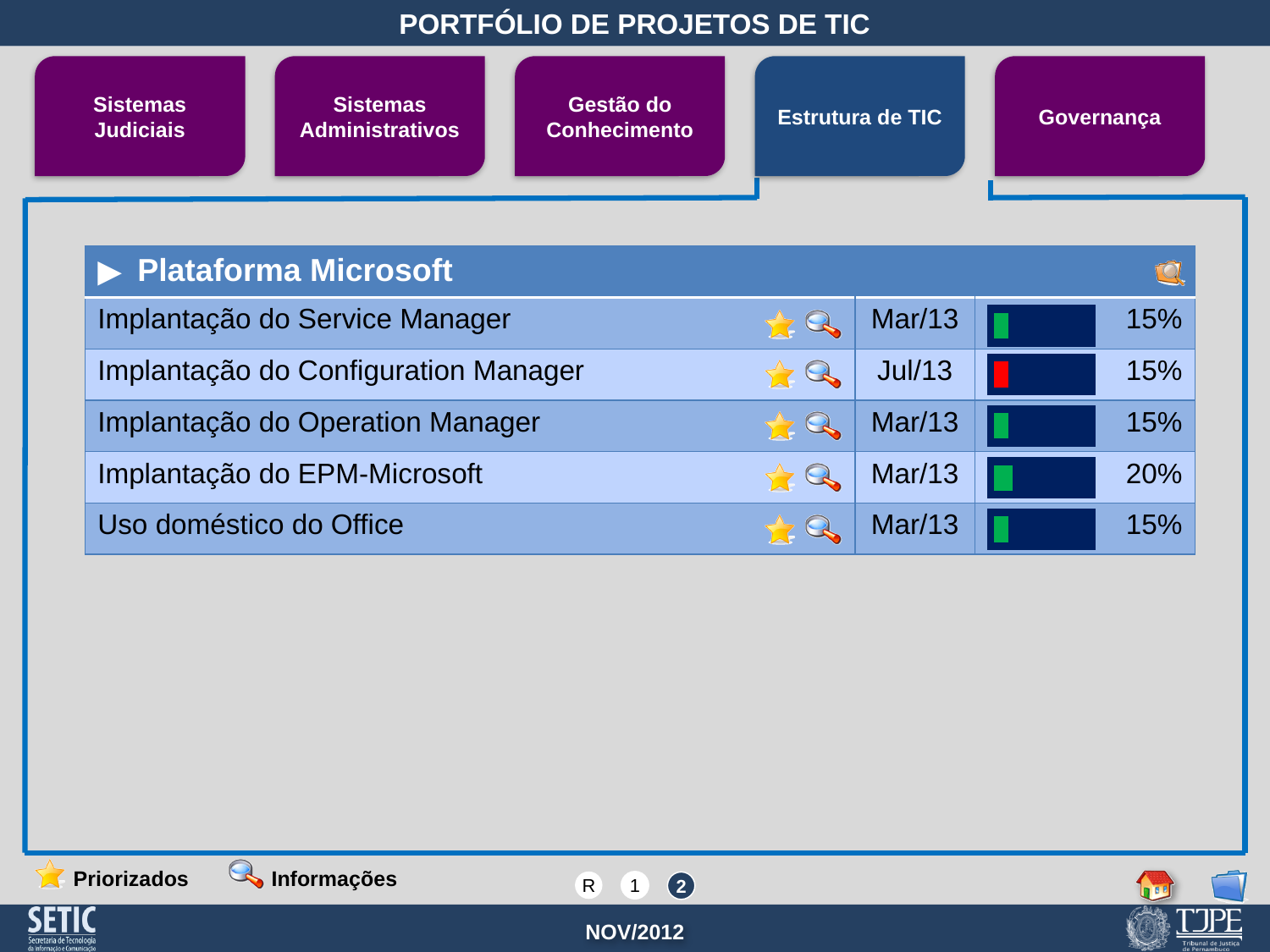
What date is shown for Implantação do Configuration Manager? Jul/13 What is the percentage shown for Implantação do EPM-Microsoft? 20% Which project under Plataforma Microsoft has the highest percentage? Implantação do EPM-Microsoft How many projects under Plataforma Microsoft show a percentage of 15%? 4 How many projects are listed under Plataforma Microsoft? 5 Which has a larger percentage, Implantação do EPM-Microsoft or Implantação do Configuration Manager? Implantação do EPM-Microsoft What is the difference between the percentage for Implantação do EPM-Microsoft and the percentage for Implantação do Operation Manager? 5% What is the percentage shown for Implantação do Service Manager? 15% What date is shown for Implantação do Service Manager? Mar/13 What is the percentage shown for Uso doméstico do Office? 15% What is the title of the group of projects shown on the slide? Plataforma Microsoft Which project's progress bar is shown in red rather than green? Implantação do Configuration Manager